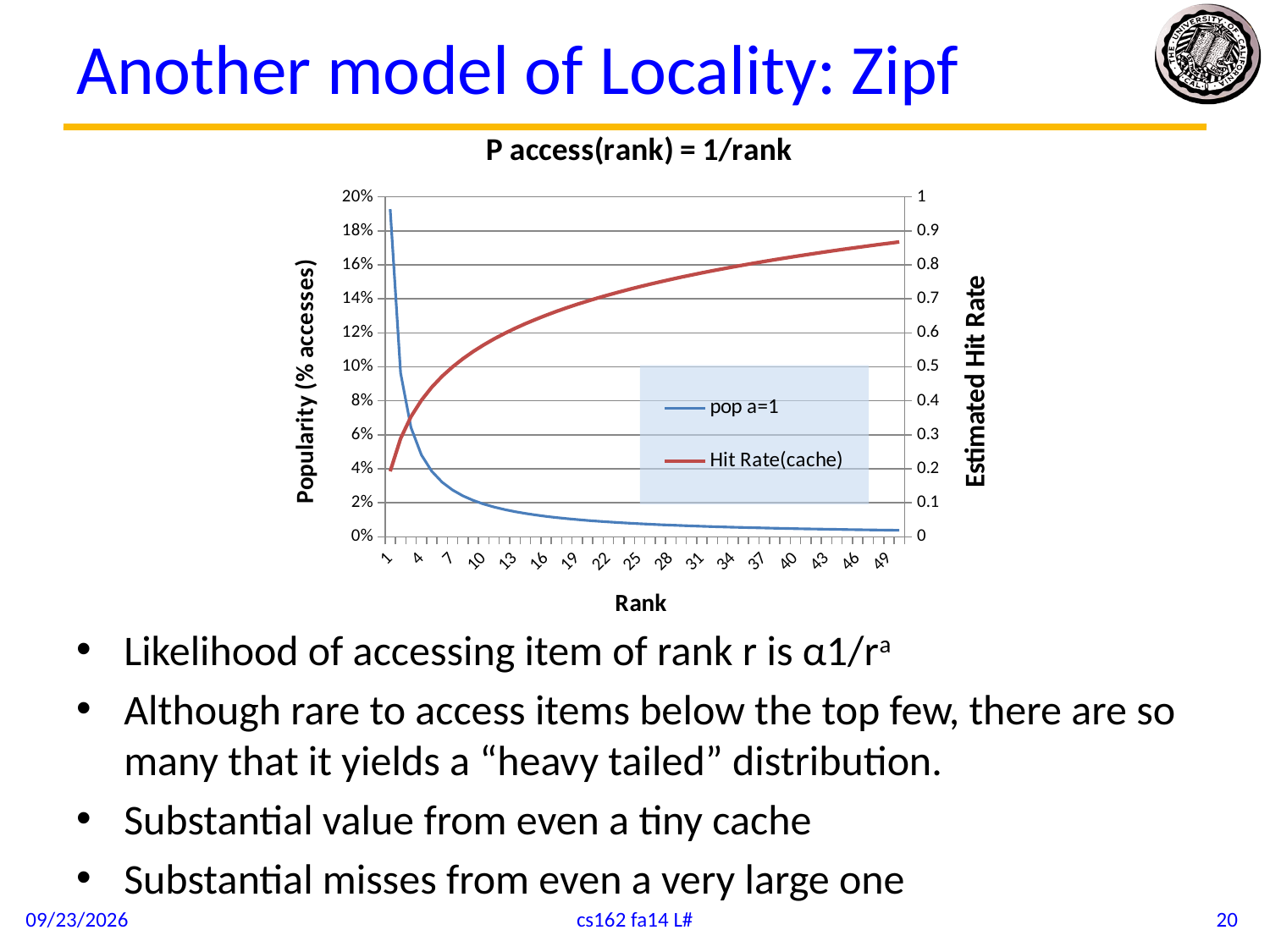
Is the 'Hit Rate(cache)' value at rank 49 greater or less than 0.8? greater Is the 'Hit Rate(cache)' value at rank 10 greater or less than 0.5? greater What is the title of the chart? P access(rank) = 1/rank Is the 'pop a=1' value at rank 4 greater or less than 10%? less What are the two series named in the chart's legend? pop a=1 and Hit Rate(cache) Does the 'Hit Rate(cache)' series rise or fall as rank increases along the x axis? rise What kind of chart is shown on the slide? line chart Does the 'pop a=1' series rise or fall as rank increases along the x axis? fall Which series is plotted in red, 'pop a=1' or 'Hit Rate(cache)'? Hit Rate(cache) How many series does the chart's legend list? 2